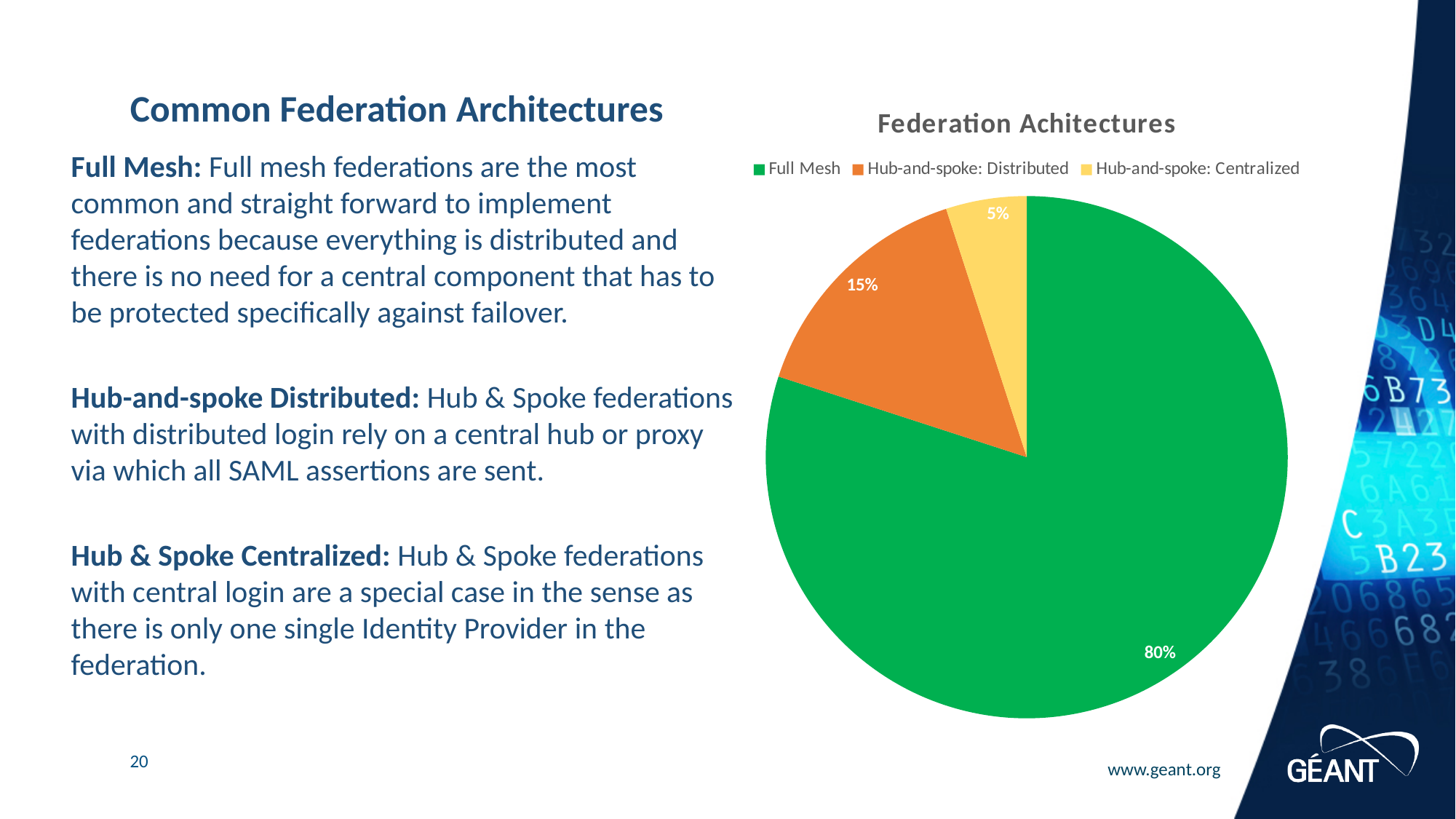
What share of the pie does Hub-and-spoke: Distributed represent? 15% What is the title of the chart? Federation Achitectures What colour is the Full Mesh slice? green Which is larger, the slice for Hub-and-spoke: Distributed or the slice for Hub-and-spoke: Centralized? Hub-and-spoke: Distributed What type of chart is shown on the slide? pie chart What share of the pie does Hub-and-spoke: Centralized represent? 5% How many categories does the pie chart show? 3 What is the difference in percentage points between Hub-and-spoke: Distributed and Hub-and-spoke: Centralized? 10 Which category has the smallest slice of the pie? Hub-and-spoke: Centralized What share of the pie does Full Mesh represent? 80% Which category has the largest slice of the pie? Full Mesh What is the difference in percentage points between Full Mesh and Hub-and-spoke: Distributed? 65